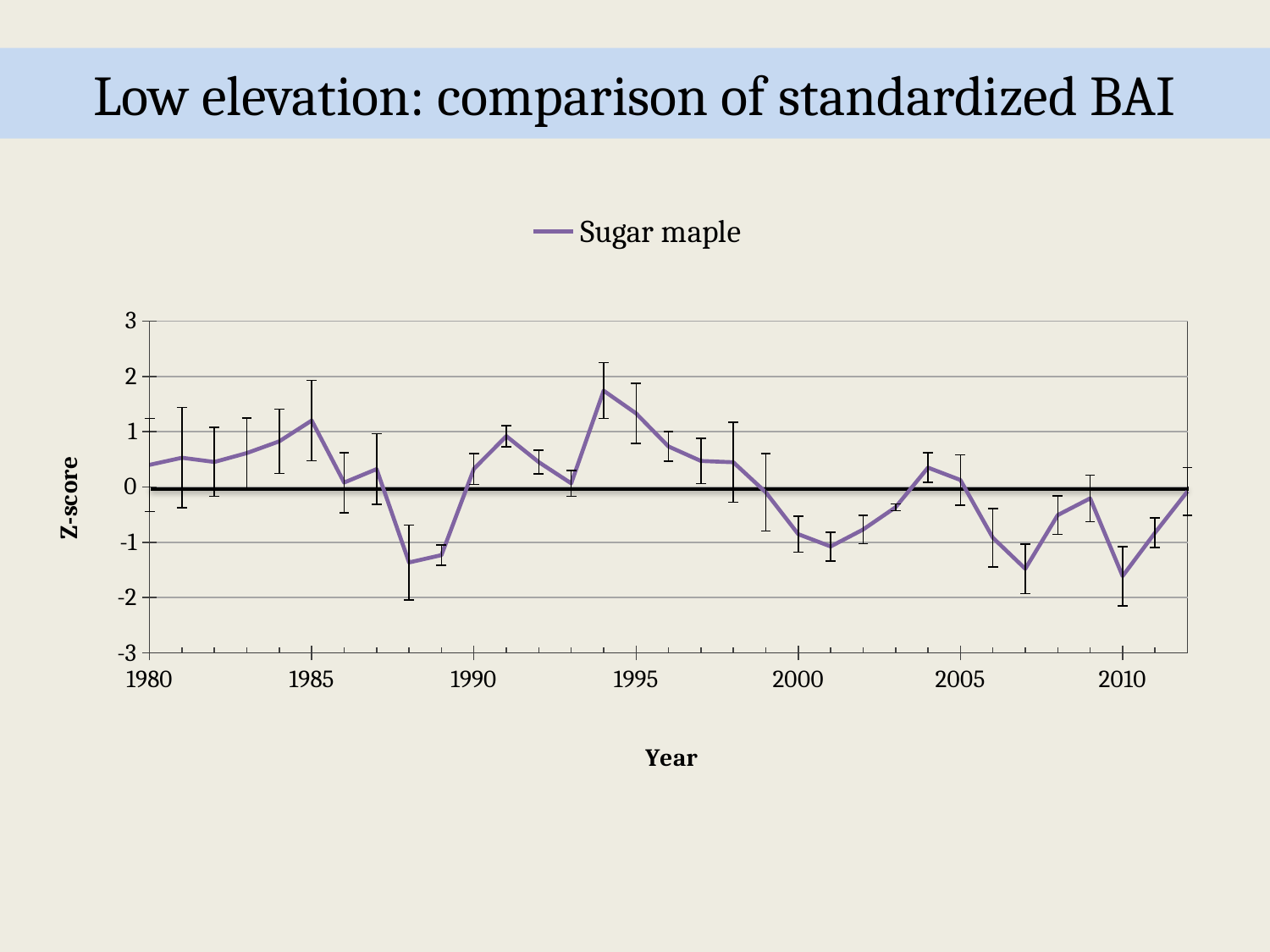
Between 1994 and 1999, does the Sugar maple Z-score generally rise or fall? fall In which year does the Sugar maple Z-score reach its highest value? 1994 How many series does the legend list? 1 What kind of chart is shown on the slide? line chart Which year has the larger Sugar maple Z-score, 1988 or 1990? 1990 Is the Sugar maple Z-score for 1994 greater or less than 1? greater Which year has the larger Sugar maple Z-score, 1994 or 1985? 1994 What is the label on the vertical axis? Z-score What series name is shown in the legend? Sugar maple Is the Sugar maple Z-score for 2010 greater or less than -1? less Is the Sugar maple Z-score for 1988 greater or less than -1? less